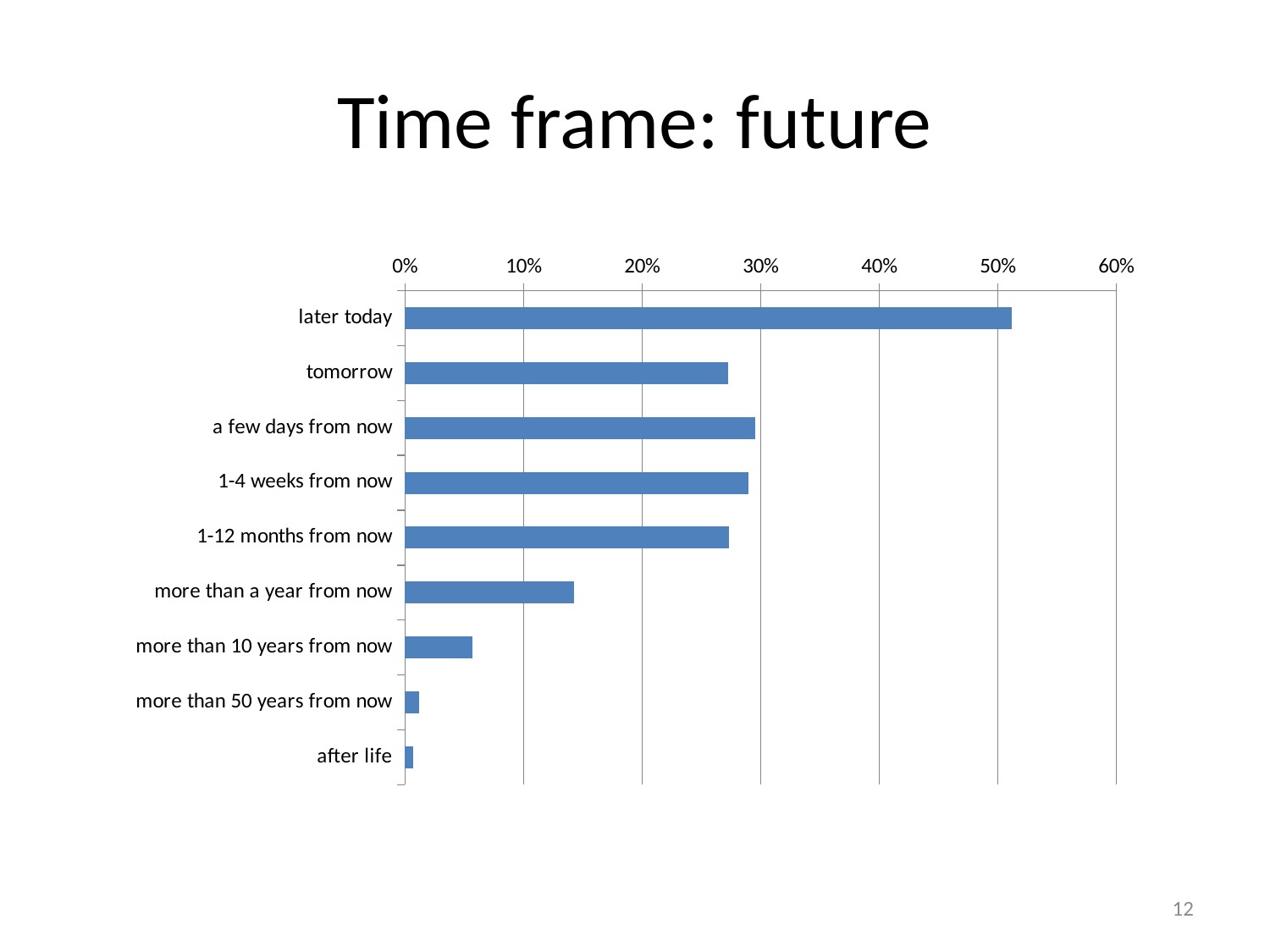
How many categories are plotted in the chart? 9 Which category has the highest value? later today Is the value for 'tomorrow' greater or less than 30%? less Is the value for 'a few days from now' greater or less than 20%? greater Is the value for 'later today' greater or less than 50%? greater What kind of chart is shown on the slide? bar chart Which is larger, the value for 'later today' or the value for 'tomorrow'? later today Which is larger, the value for 'more than a year from now' or the value for 'more than 10 years from now'? more than a year from now What is the title of the slide containing the chart? Time frame: future